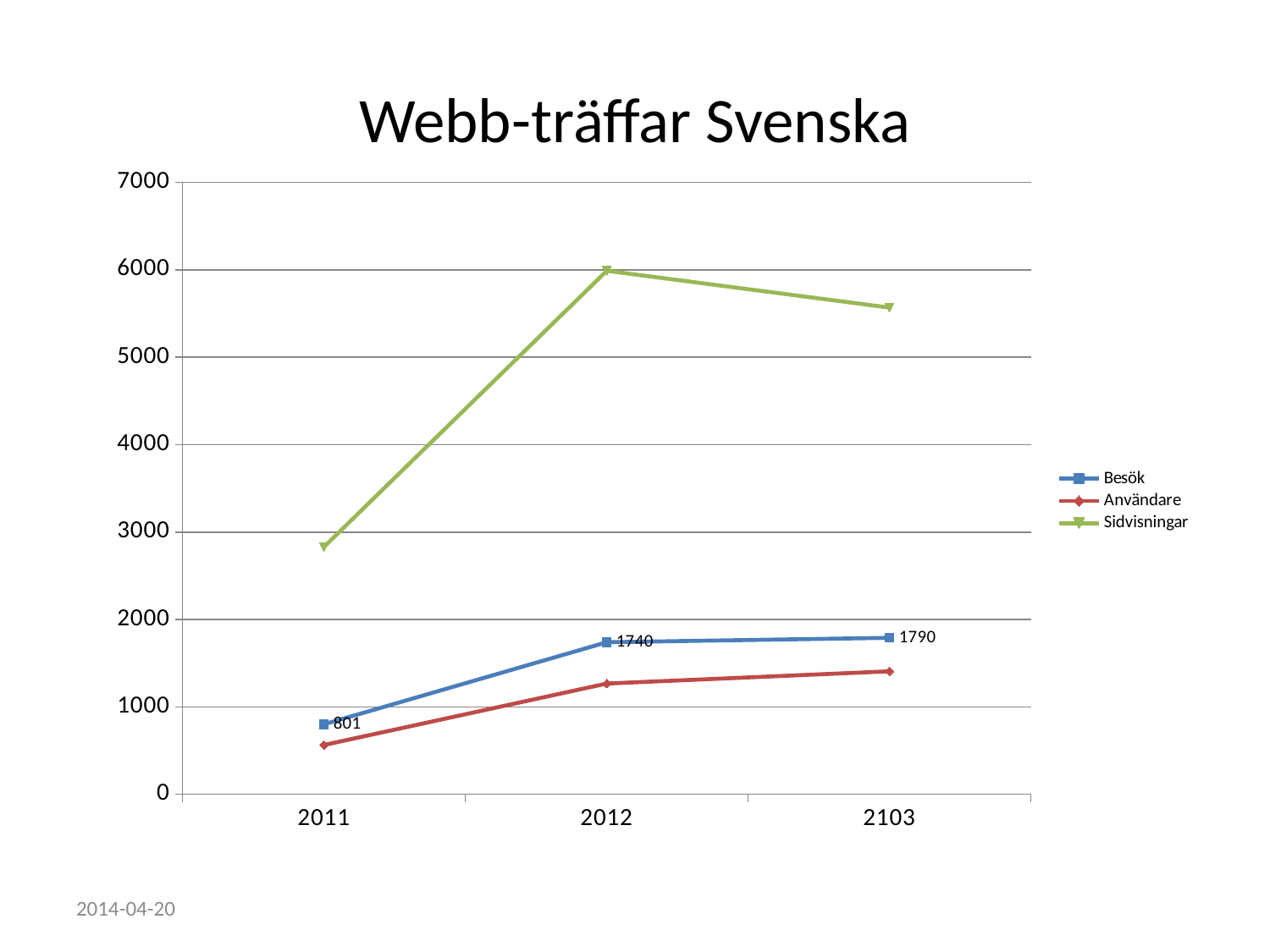
Is the value for Sidvisningar in 2103 greater or less than 5000? greater Which series has the highest value in 2012? Sidvisningar What is the difference between the Besök values for 2103 and 2012? 50 What is the value of Besök for 2103? 1790 How many categories are shown on the x axis? 3 How many series does the legend list? 3 Is the value for Sidvisningar in 2011 greater or less than 3000? less What is the value of Besök for 2011? 801 What kind of chart is shown on the slide? line chart What is the value of Besök for 2012? 1740 By how much did Besök increase from 2011 to 2012? 939 What is the title of the chart? Webb-träffar Svenska